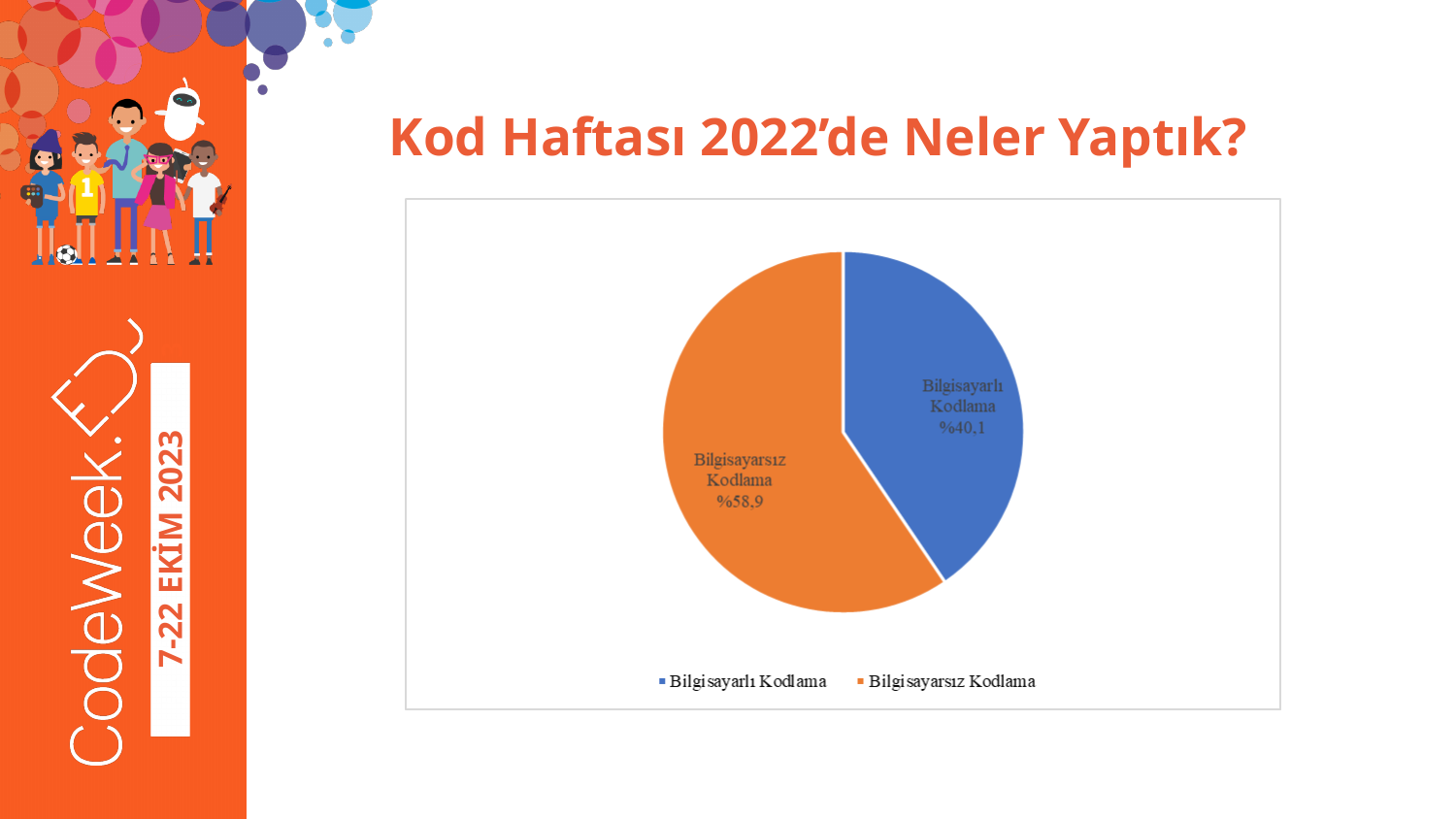
Which slice of the pie is the smallest? Bilgisayarlı Kodlama Which is larger, Bilgisayarlı Kodlama or Bilgisayarsız Kodlama? Bilgisayarsız Kodlama How many entries does the legend list? 2 What is the value shown for Bilgisayarlı Kodlama? %40,1 What is the title of the slide containing the chart? Kod Haftası 2022'de Neler Yaptık? What is the difference between the values for Bilgisayarsız Kodlama and Bilgisayarlı Kodlama? %18,8 What colour is the Bilgisayarsız Kodlama slice? Orange How many slices does the pie chart have? 2 Which slice of the pie is the largest? Bilgisayarsız Kodlama What kind of chart is shown on the slide? Pie chart What is the value shown for Bilgisayarsız Kodlama? %58,9